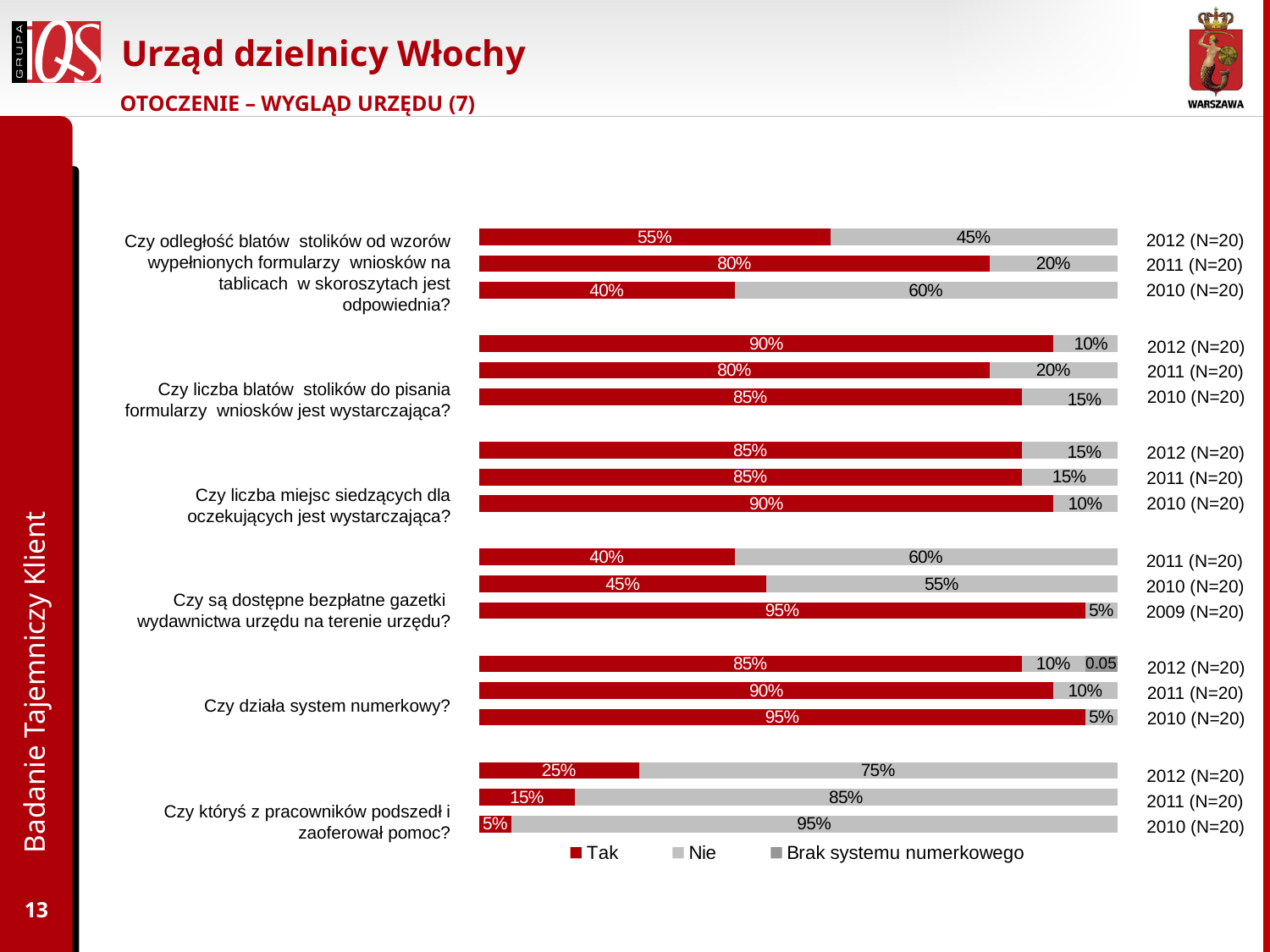
For the question 'Czy są dostępne bezpłatne gazetki wydawnictwa urzędu na terenie urzędu?', is the 'Tak' value larger in 2011 (N=20) or 2010 (N=20)? 2010 (N=20) What is the 'Tak' value for 2009 (N=20) for the question 'Czy są dostępne bezpłatne gazetki wydawnictwa urzędu na terenie urzędu?' 95% For the question 'Czy liczba blatów stolików do pisania formularzy wniosków jest wystarczająca?', which year has the lowest 'Tak' value? 2011 (N=20) For the question 'Czy któryś z pracowników podszedł i zaoferował pomoc?', which year has the highest 'Tak' value? 2012 (N=20) What kind of chart is shown on the slide? bar chart What is the 'Brak systemu numerkowego' value for 2012 (N=20) for the question 'Czy działa system numerkowy?' 0.05 What is the third legend entry in the chart? Brak systemu numerkowego How many series does the legend list? 3 What is the 'Nie' value for 2010 (N=20) for the question 'Czy odległość blatów stolików od wzorów wypełnionych formularzy wniosków na tablicach w skoroszytach jest odpowiednia?' 60% What is the 'Tak' value for 2012 (N=20) for the question 'Czy działa system numerkowy?' 85% What is the difference between the 'Tak' values for 2011 (N=20) and 2010 (N=20) for the question 'Czy odległość blatów stolików od wzorów wypełnionych formularzy wniosków na tablicach w skoroszytach jest odpowiednia?' 40% What is the 'Nie' value for 2010 (N=20) for the question 'Czy któryś z pracowników podszedł i zaoferował pomoc?' 95%